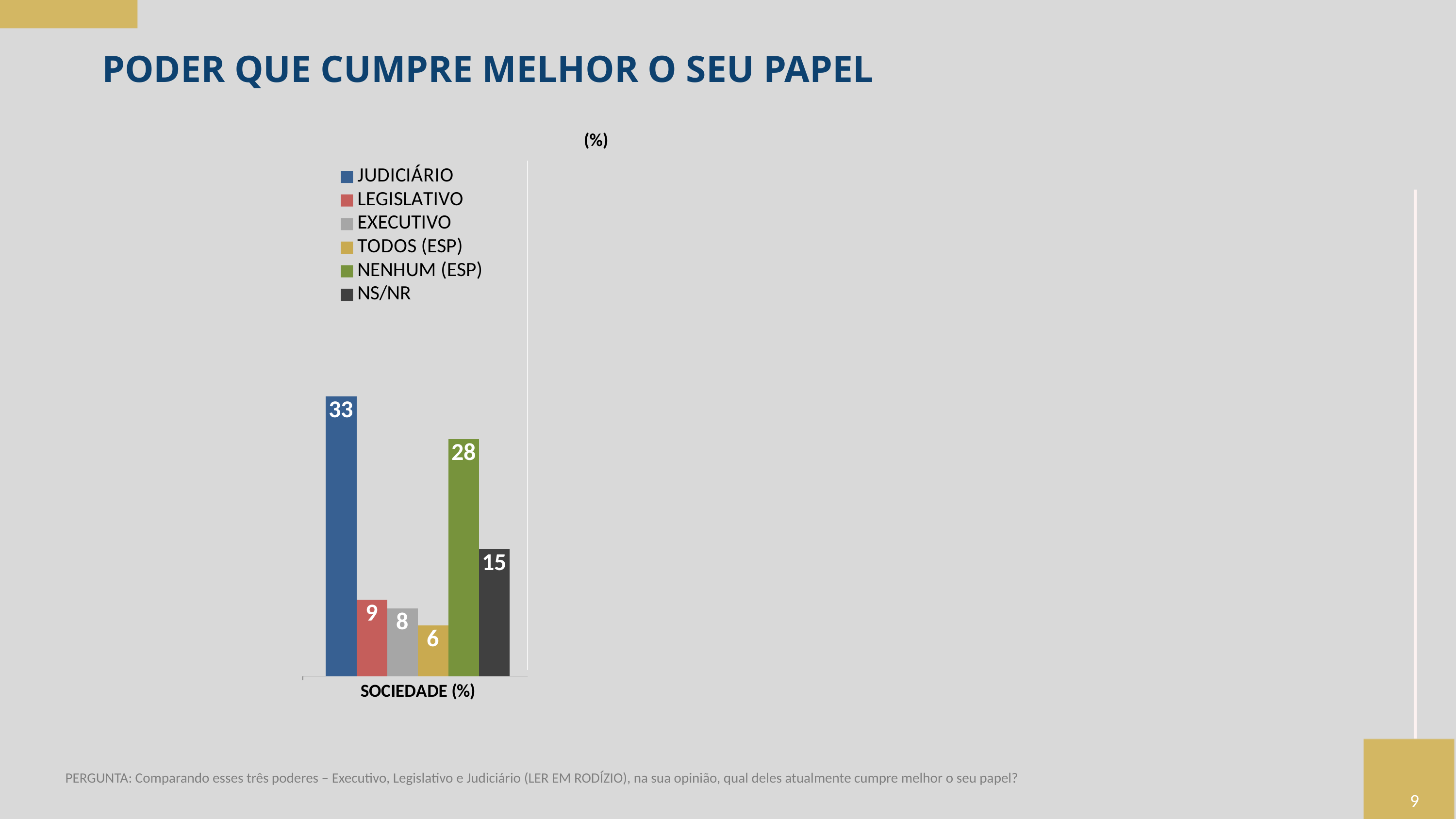
Which is larger, the value for LEGISLATIVO or the value for EXECUTIVO? LEGISLATIVO What kind of chart is shown on the slide? bar chart What colour is the bar for NENHUM (ESP)? green How many series does the legend list? 6 What is the value for JUDICIÁRIO? 33 Which series has the lowest value? TODOS (ESP) What is the value for NENHUM (ESP)? 28 What is the label on the x axis category? SOCIEDADE (%) What is the value for TODOS (ESP)? 6 Which series has the highest value? JUDICIÁRIO What is the difference between the values for JUDICIÁRIO and NENHUM (ESP)? 5 What is the value for NS/NR? 15